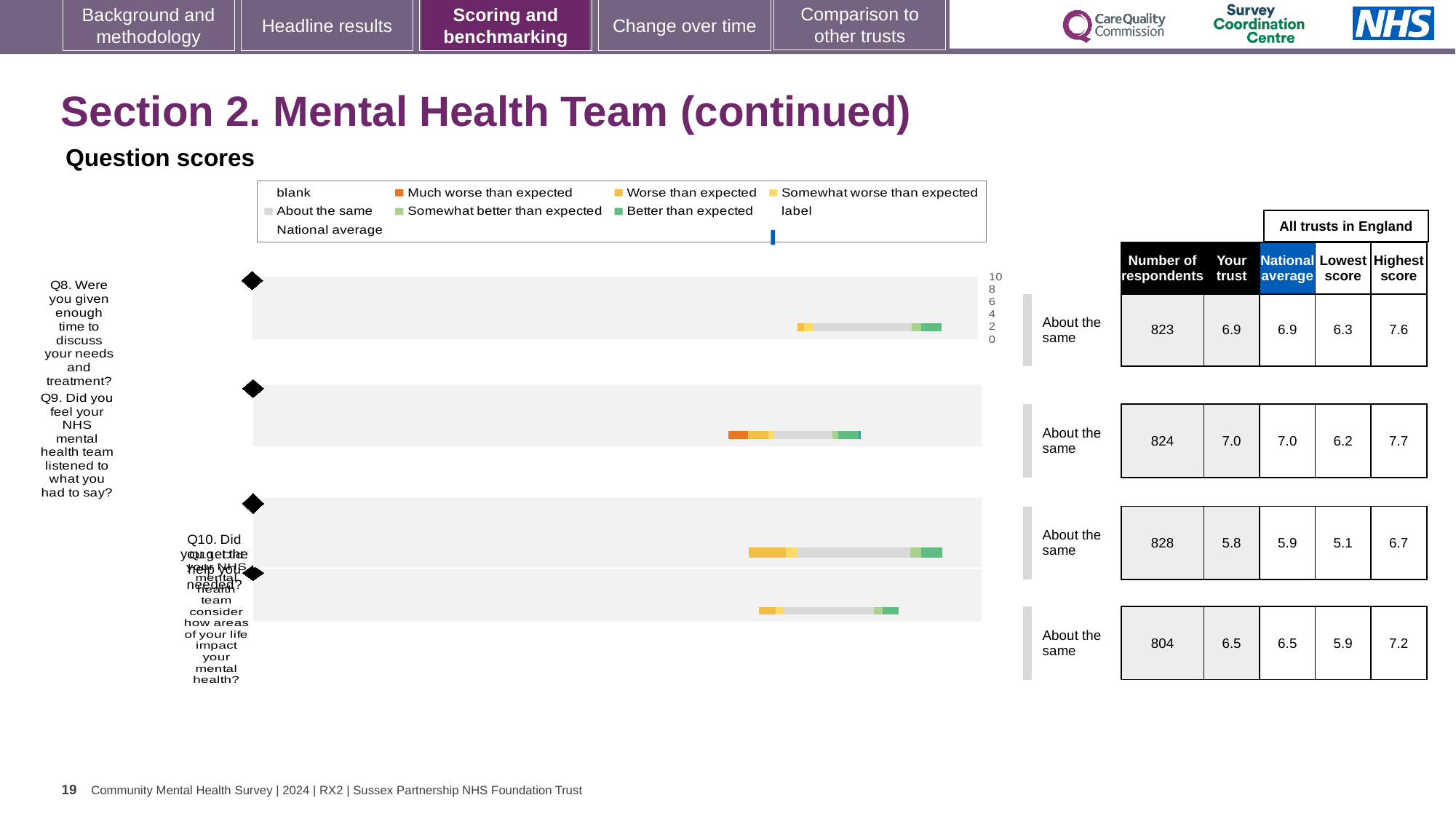
Which question has the highest 'Your trust' score? Q9 What benchmark category is shown for all four questions? About the same What is the number of respondents for Q9 (Did you feel your NHS mental health team listened to what you had to say?)? 824 Which has the larger 'Your trust' score, Q8 or Q11? Q8 Which question has the lowest 'Your trust' score? Q10 What is the national average score for Q10 (Did you get the help you needed?)? 5.9 What is the difference between the highest score and the lowest score for Q10? 1.6 Which question has the most respondents? Q10 What is the 'Your trust' score for Q8 (Were you given enough time to discuss your needs and treatment?)? 6.9 How many questions (rows) are plotted in the chart? 4 What kind of chart is shown on the slide? bar chart What is the highest score among all trusts in England for Q11? 7.2